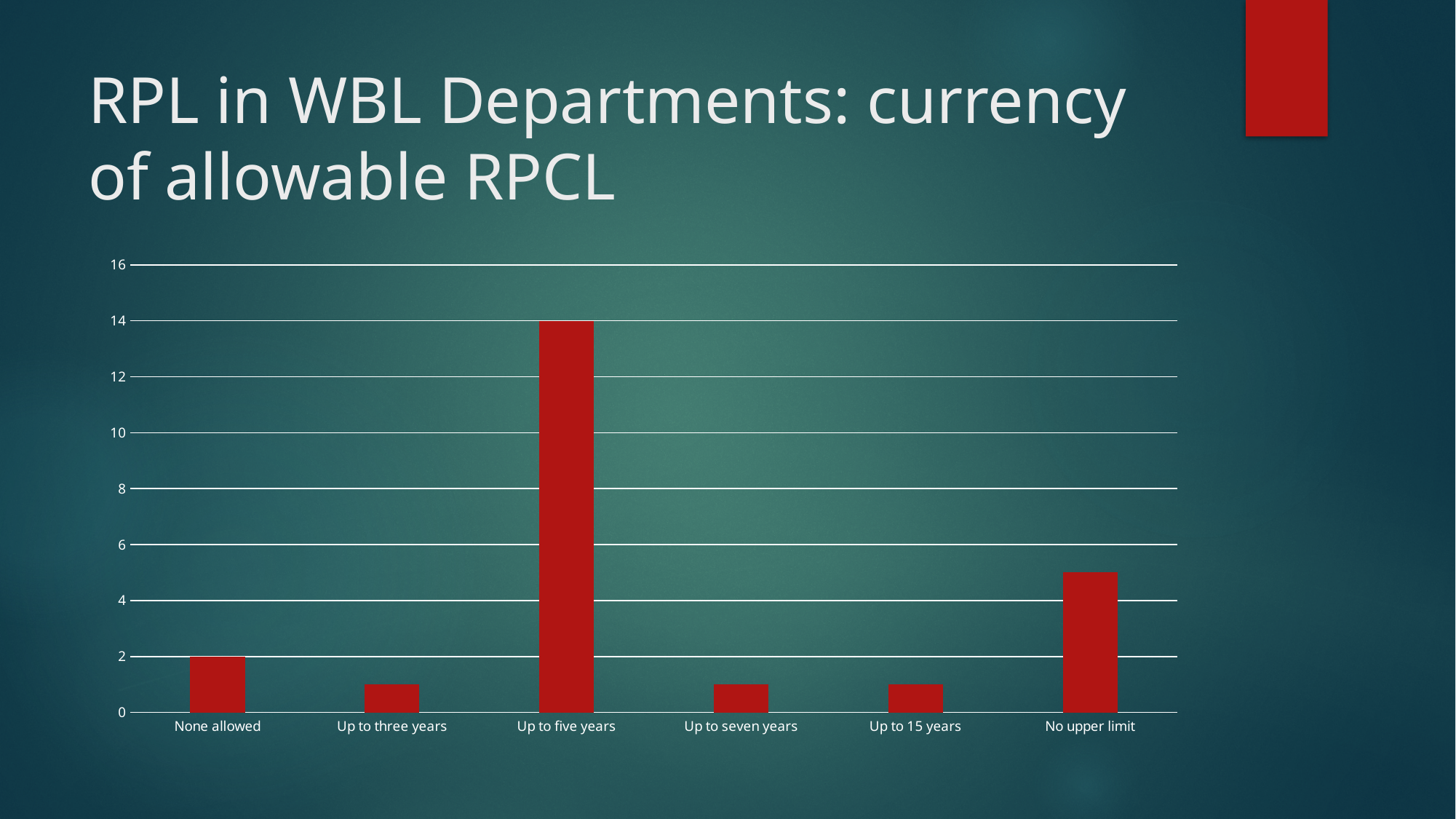
What is the difference between the values for Up to five years and None allowed? 12 Which category has the highest bar? Up to five years Which is larger, the value for No upper limit or the value for Up to 15 years? No upper limit How many categories are shown on the x axis of the chart? 6 Is the value for Up to three years greater or less than 2? less What is the title of the slide containing the chart? RPL in WBL Departments: currency of allowable RPCL Is the value for No upper limit greater or less than 4? greater What is the value for None allowed? 2 Is the value for No upper limit greater or less than 6? less What kind of chart is shown on the slide? bar chart Which is larger, the value for None allowed or the value for Up to seven years? None allowed What is the value for Up to five years? 14